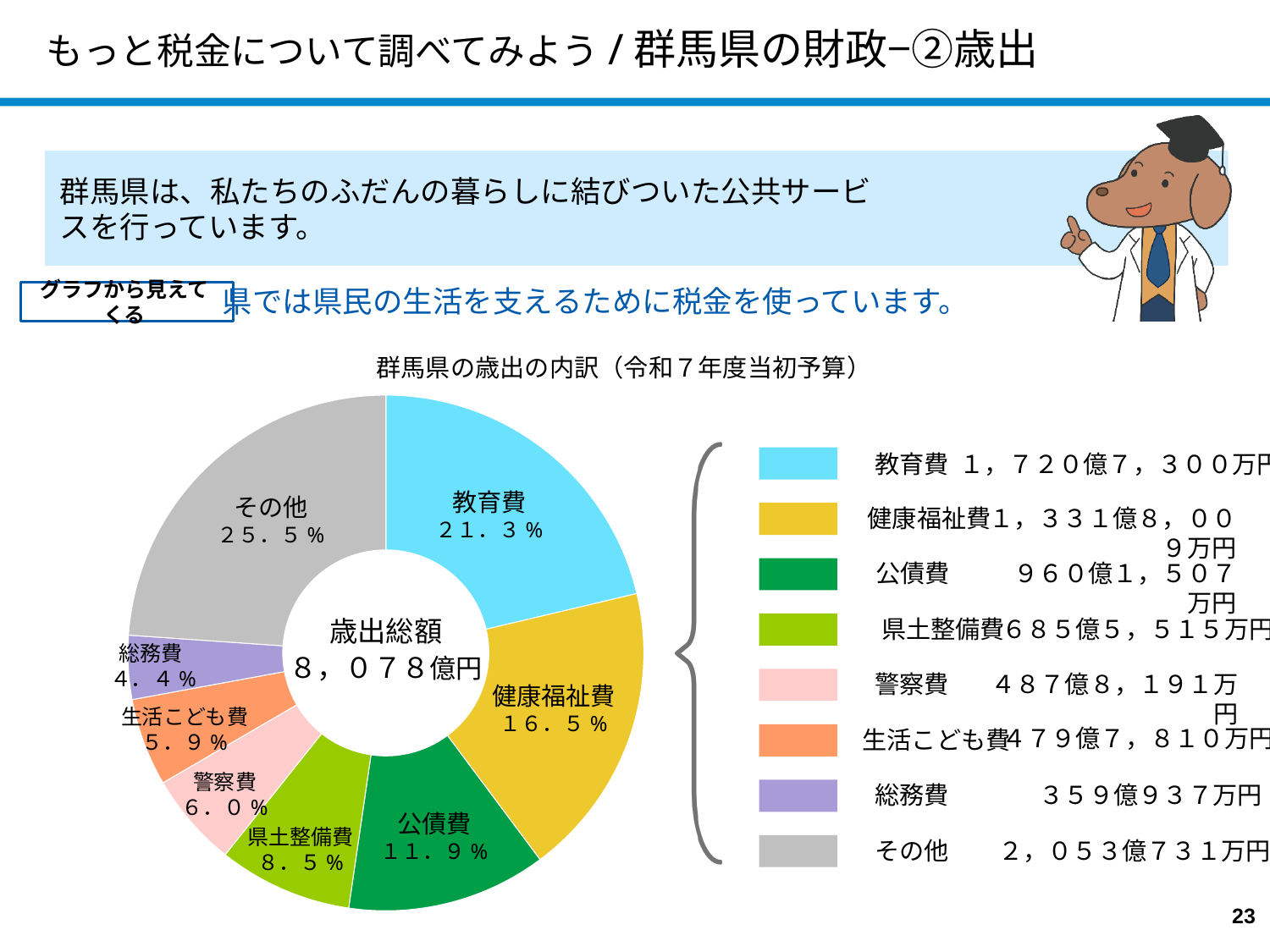
What is the difference in percentage points between 教育費 and 健康福祉費? ４．８％ What is the title of the chart? 群馬県の歳出の内訳（令和７年度当初予算） Which has a larger share, 県土整備費 or 警察費? 県土整備費 Which category has the smallest share in the chart? 総務費 What kind of chart is shown on the slide? Pie chart (donut) What percentage share does 総務費 have in the chart? ４．４％ What percentage share does 教育費 have in the chart? ２１．３％ What percentage share does 健康福祉費 have in the chart? １６．５％ What percentage share does 公債費 have in the chart? １１．９％ What is the total expenditure (歳出総額) shown in the centre of the chart? ８，０７８億円 Which category has the largest share in the chart? その他 How many categories (slices) does the chart show? 8